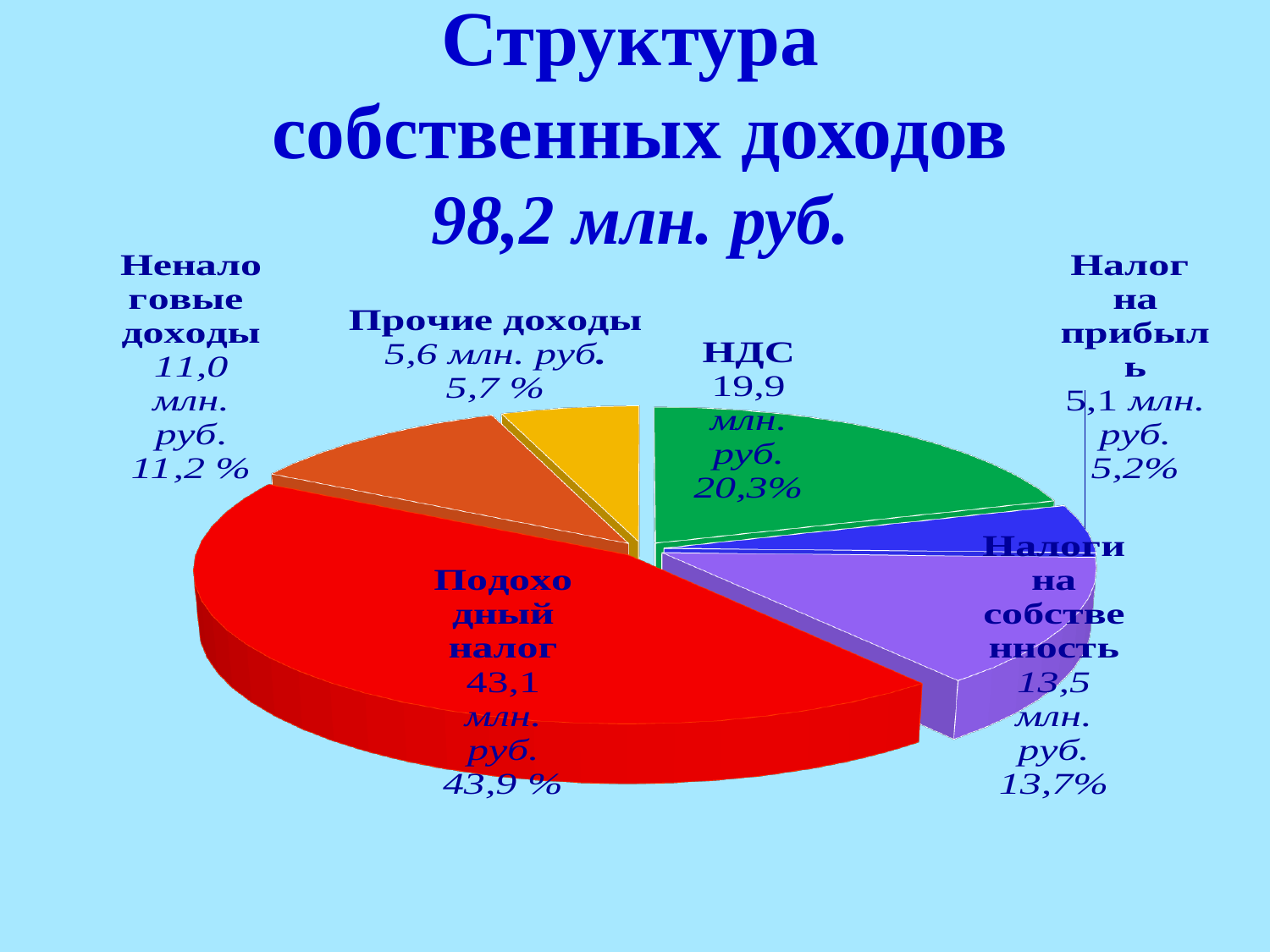
What kind of chart is shown on the slide? pie chart What colour is the slice for НДС? green Which category has the largest slice of the pie? Подоходный налог What percentage share do Неналоговые доходы have? 11,2 % What total amount is stated in the chart title? 98,2 млн. руб. What is the value for Подоходный налог in млн. руб.? 43,1 млн. руб. How many slices does the pie chart have? 6 Which is larger: Прочие доходы or Налог на прибыль? Прочие доходы What percentage share does НДС have? 20,3% What is the value for Налоги на собственность in млн. руб.? 13,5 млн. руб. What is the difference in млн. руб. between Подоходный налог and НДС? 23,2 млн. руб. Which category has the smallest slice of the pie? Налог на прибыль